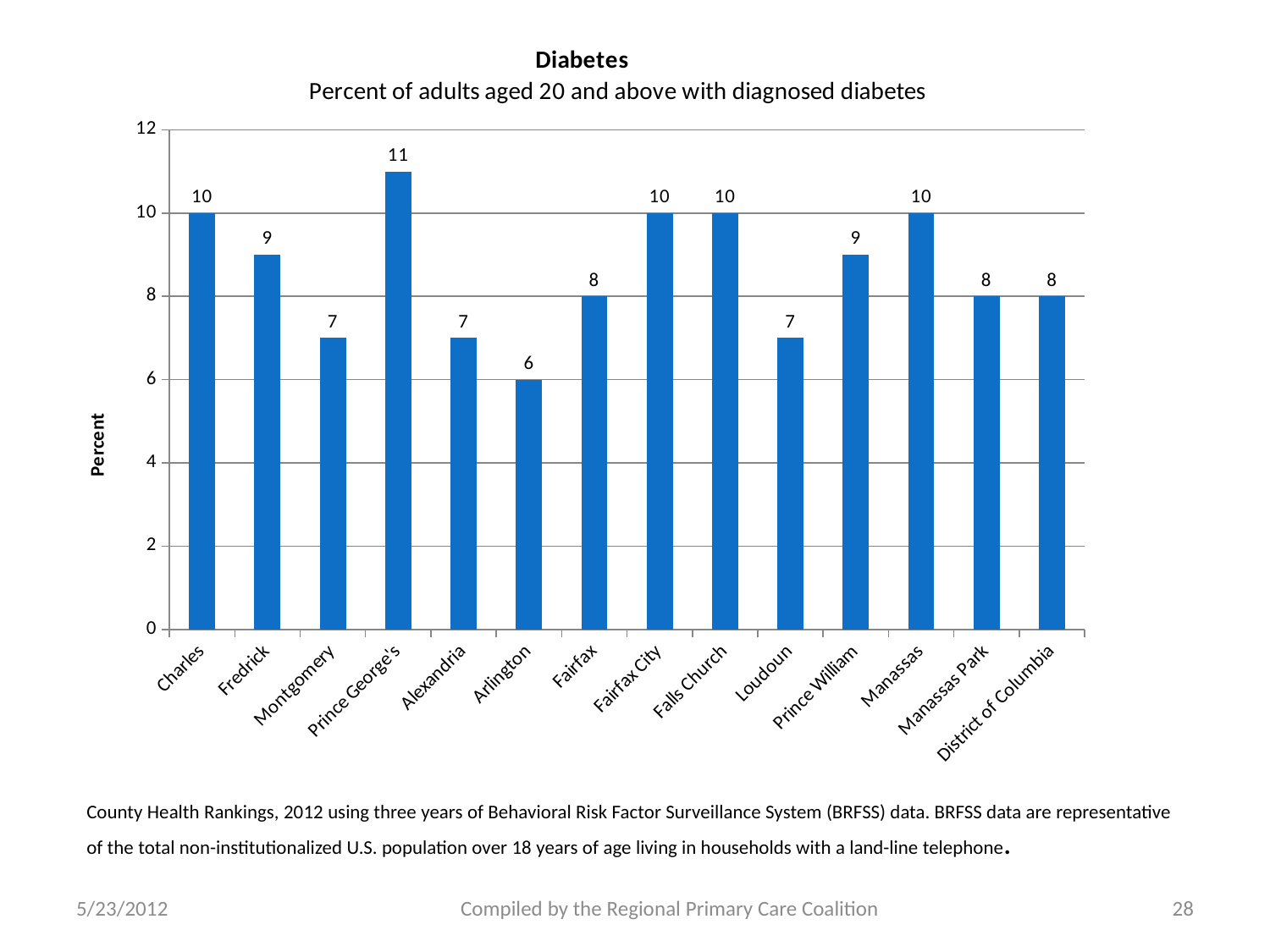
What is the value for Loudoun? 7 Which category has the lowest value? Arlington What is the label on the y axis? Percent What is the value for Arlington? 6 Which is larger, the value for Fredrick or the value for Montgomery? Fredrick What is the difference between the values for Prince George's and Arlington? 5 How many categories are shown on the x axis? 14 What is the difference between the values for Charles and Fairfax? 2 What is the value for Prince George's? 11 What is the title of the chart? Diabetes What kind of chart is this? Bar chart Which category has the highest value? Prince George's